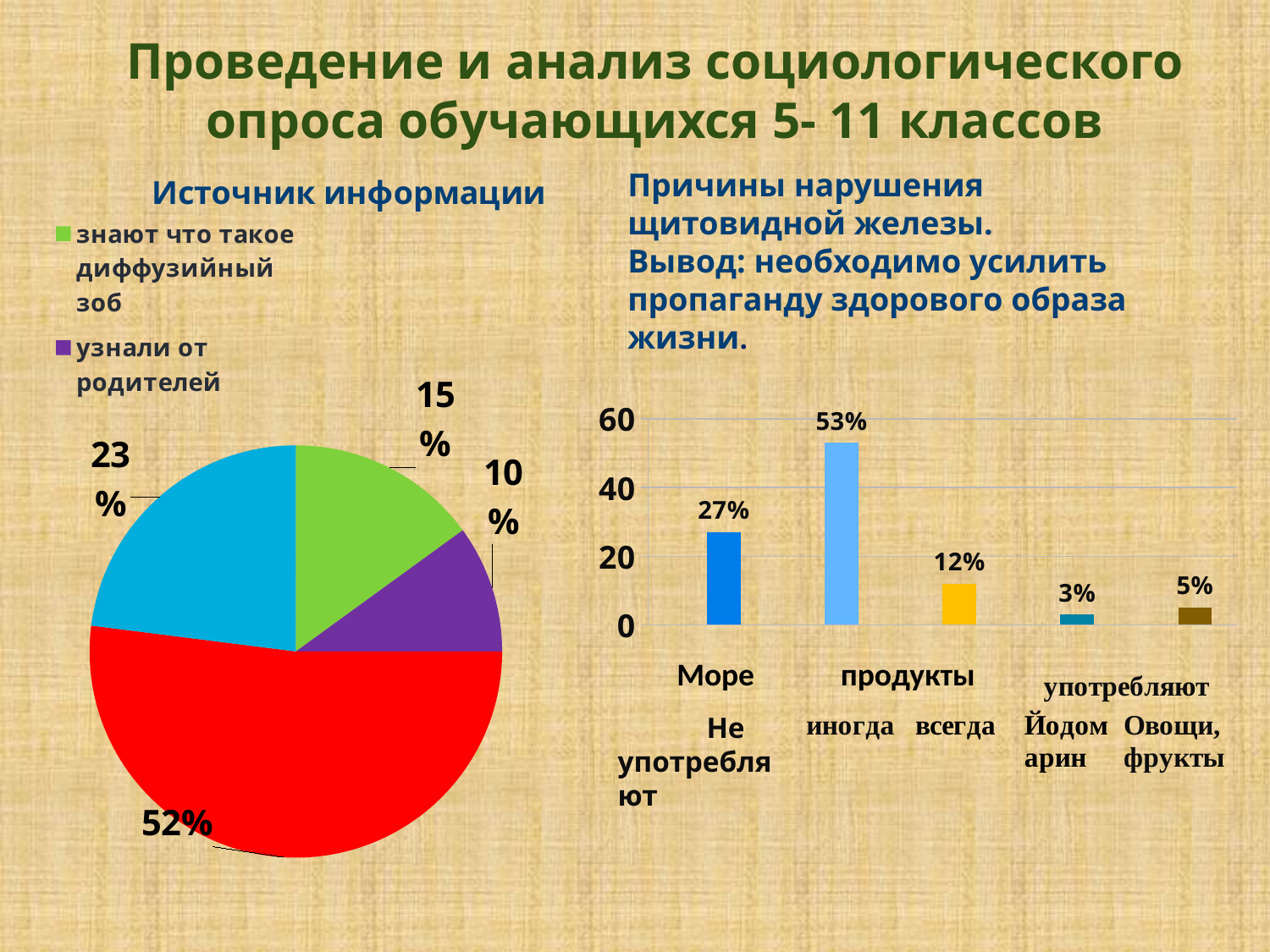
In the bar chart on the right of the slide, which category has the lowest value? Йодомарин In the pie chart titled "Источник информации", how many slices are there? 4 In the bar chart on the right of the slide, which category has the highest value? иногда In the pie chart titled "Источник информации", what is the value for "узнали от родителей"? 10% In the pie chart titled "Источник информации", what is the value for "знают что такое диффузийный зоб"? 15% In the bar chart on the right of the slide, what is the value for "иногда"? 53% In the pie chart titled "Источник информации", how many entries does the legend list? 2 In the bar chart on the right of the slide, how many bars are there? 5 In the bar chart on the right of the slide, what is the difference between the values for "иногда" and "всегда"? 41% In the bar chart on the right of the slide, what is the value for "Йодомарин"? 3% What kind of chart is the chart titled "Источник информации"? Pie chart In the pie chart titled "Источник информации", what is the value of the largest slice? 52%